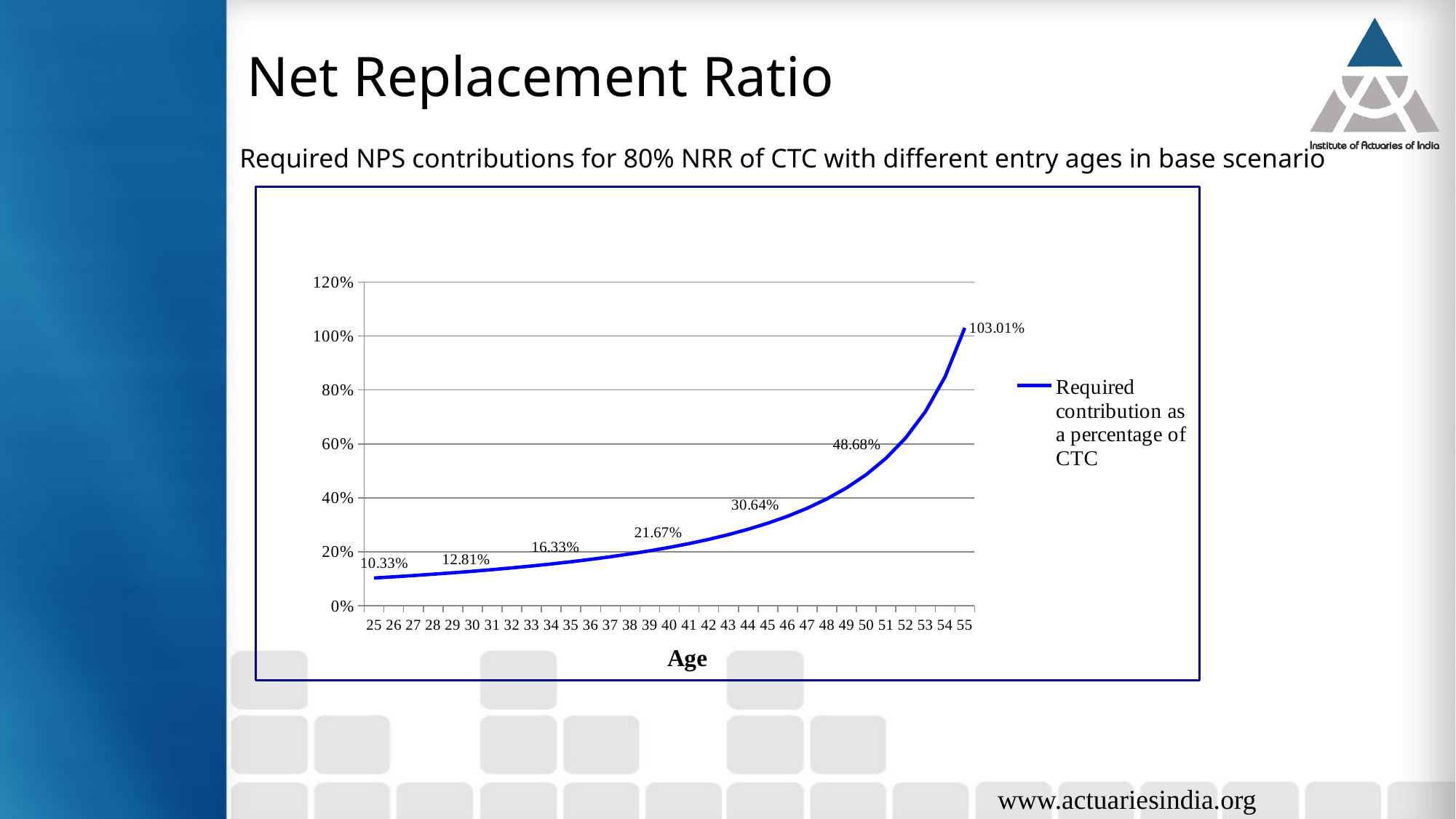
Is the required contribution at entry age 53 greater or less than 60%? greater What is the required contribution as a percentage of CTC at entry age 50? 48.68% What is the required contribution as a percentage of CTC at entry age 25? 10.33% What is the difference between the required contribution at age 55 and at age 25? 92.68% Which entry age has a larger required contribution, 45 or 50? 50 How many series does the legend list? 1 What kind of chart is shown on the slide? line chart Does the required contribution rise or fall as entry age increases along the x axis? rises At which entry age is the required contribution highest? 55 At which entry age is the required contribution lowest? 25 What is the required contribution as a percentage of CTC at entry age 55? 103.01% What is the required contribution as a percentage of CTC at entry age 40? 21.67%